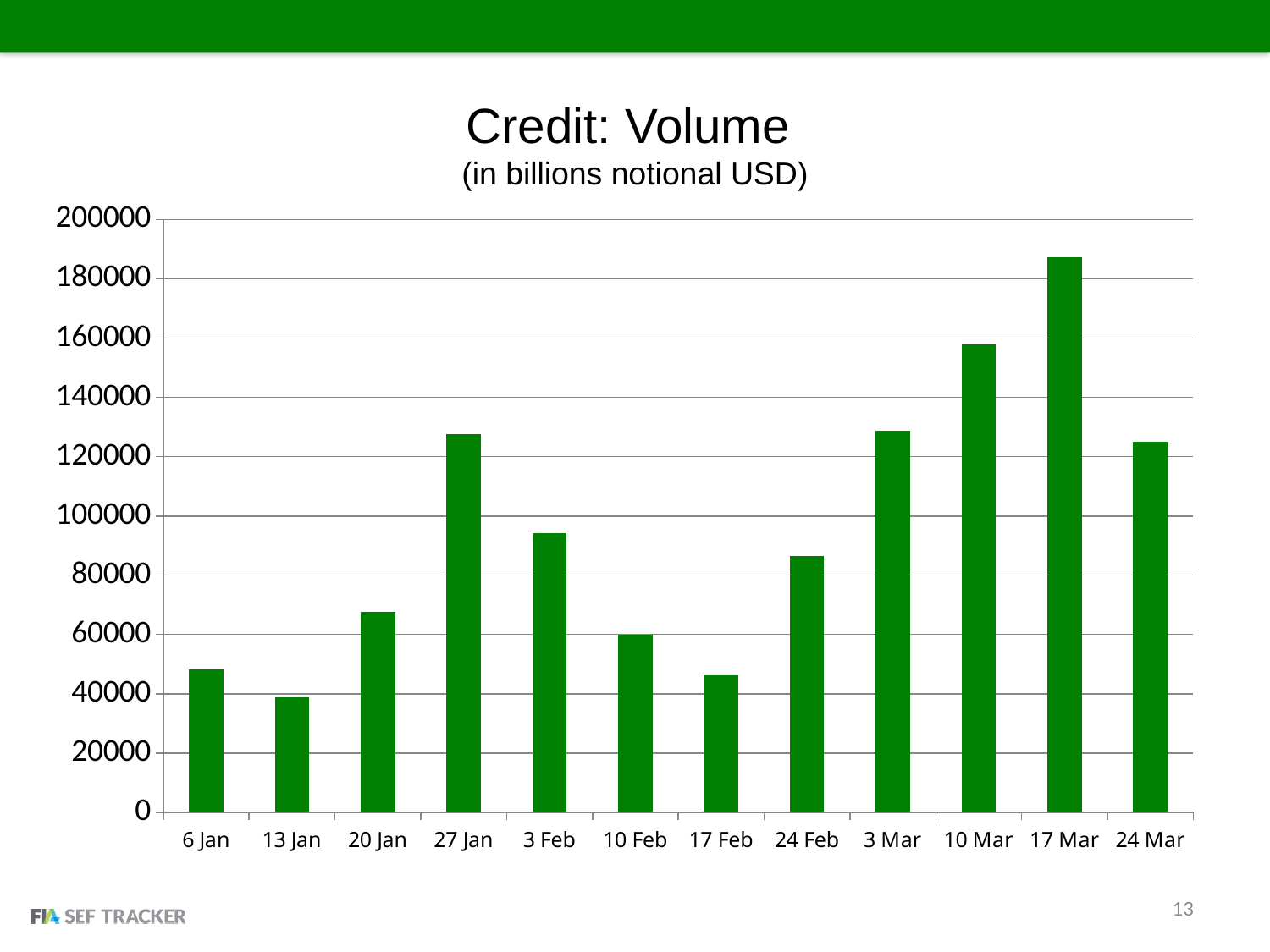
Which date has the lowest credit volume? 13 Jan Is the value for 24 Mar greater or less than 120000? greater Which date has the highest credit volume? 17 Mar What type of chart is shown on the slide? Bar chart How many weekly dates are shown on the x axis of the chart? 12 Is the value for 24 Feb greater or less than 80000? greater Which is larger, the value for 10 Mar or the value for 24 Mar? 10 Mar What unit does the chart subtitle say the volumes are in? billions notional USD Is the value for 17 Mar greater or less than 180000? greater